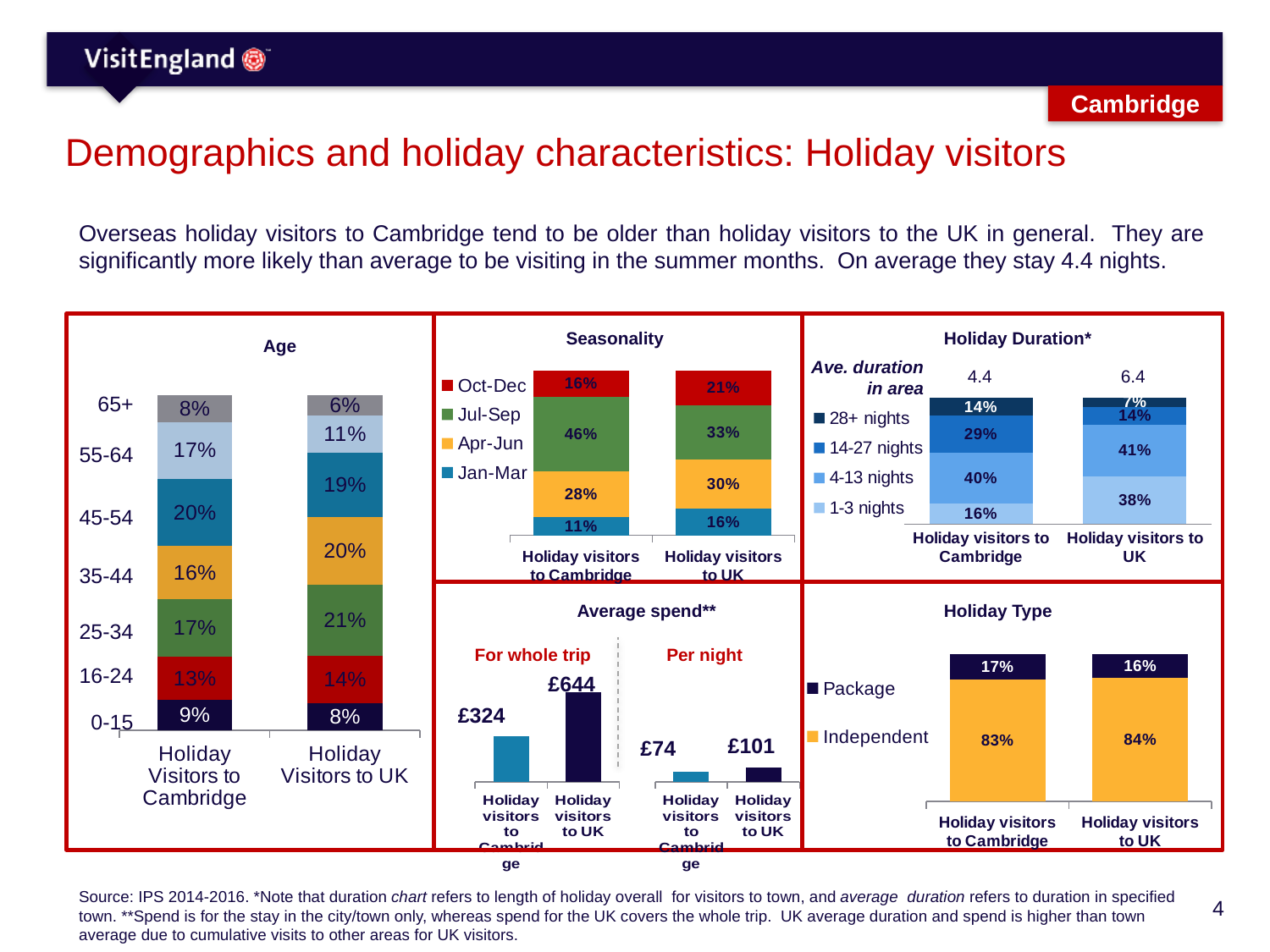
In the Holiday Duration chart, what percentage of holiday visitors to the UK stay 1-3 nights? 38% In the Holiday Duration chart, what is the average duration in area for holiday visitors to Cambridge? 4.4 What kind of chart is the Holiday Type chart? Stacked bar chart In the Holiday Type chart, what percentage of holiday visitors to Cambridge are on a package holiday? 17% In the Seasonality chart, which season has the smallest share for holiday visitors to Cambridge? Jan-Mar In the Seasonality chart, what share of holiday visitors to Cambridge visit in Jul-Sep? 46% In the Age chart, what percentage of holiday visitors to the UK are aged 65+? 6% In the Seasonality chart, what is the difference between the Jul-Sep share for holiday visitors to Cambridge and for holiday visitors to the UK? 13% In the Average spend chart, what is the difference in per-night spend between holiday visitors to the UK and holiday visitors to Cambridge? £27 In the Age chart, what percentage of holiday visitors to Cambridge are aged 45-54? 20% In the Average spend chart, what is the spend for the whole trip for holiday visitors to Cambridge? £324 In the Holiday Duration chart, how many duration categories does the legend list? 4